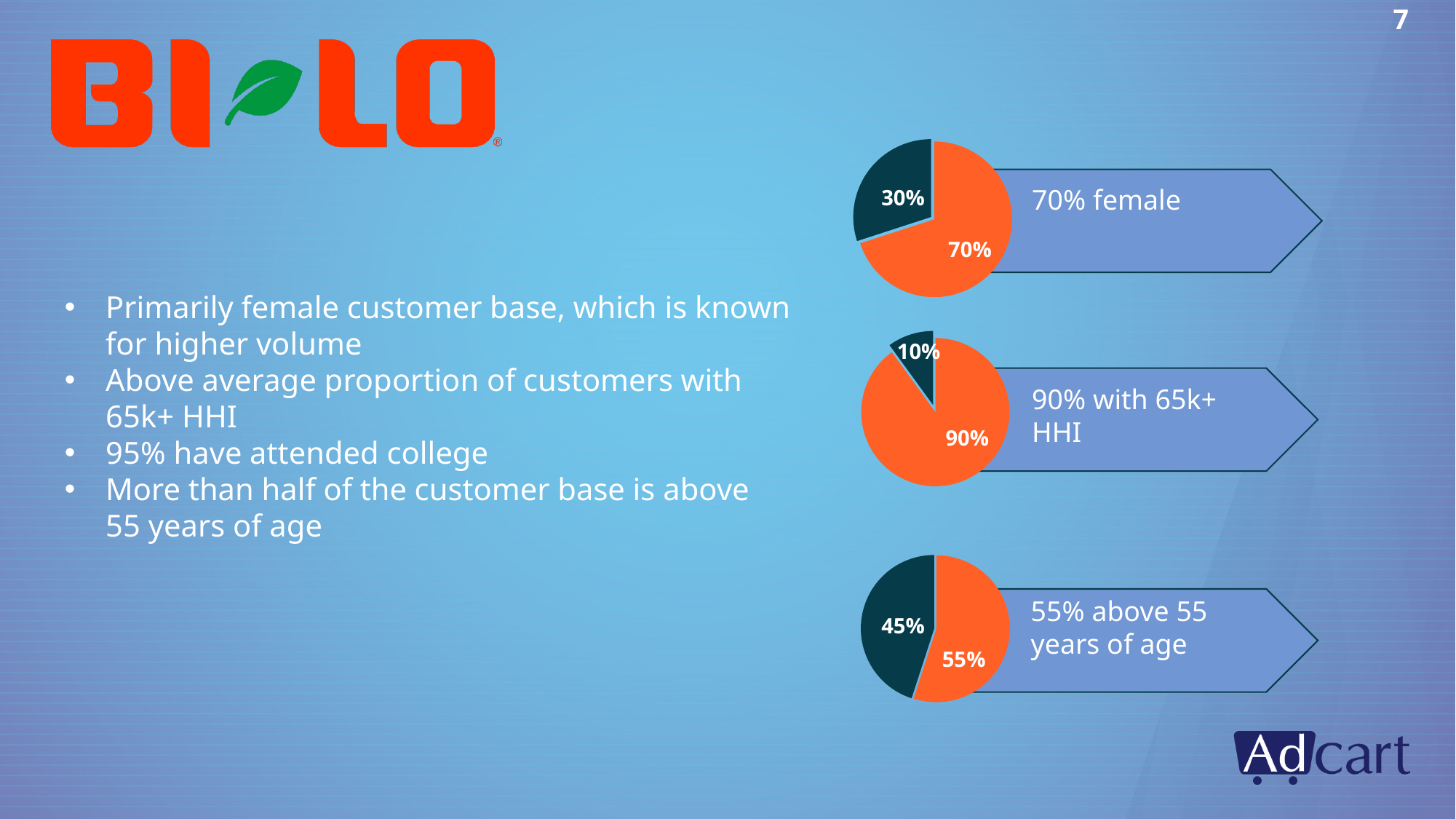
What kind of chart is used on the right side of the slide next to the text '70% female'? pie chart Which of the three pie charts has the largest orange slice? the middle one (90% with 65k+ HHI) In the middle pie chart (next to '90% with 65k+ HHI'), what value is printed on the small dark slice? 10% In the bottom pie chart (next to '55% above 55 years of age'), what is the difference between the orange slice and the dark slice? 10% In the top pie chart (next to '70% female'), what is the difference between the orange slice and the dark slice? 40% In the middle pie chart (next to '90% with 65k+ HHI'), what value is printed on the orange slice? 90% How many pie charts are shown on the slide? 3 In the top pie chart (next to '70% female'), what value is printed on the orange slice? 70% How many slices does each pie chart on the slide have? 2 In the top pie chart (next to '70% female'), what value is printed on the dark slice? 30% In the middle pie chart (next to '90% with 65k+ HHI'), which slice is larger, the orange one or the dark one? the orange one In the bottom pie chart (next to '55% above 55 years of age'), what value is printed on the dark slice? 45%